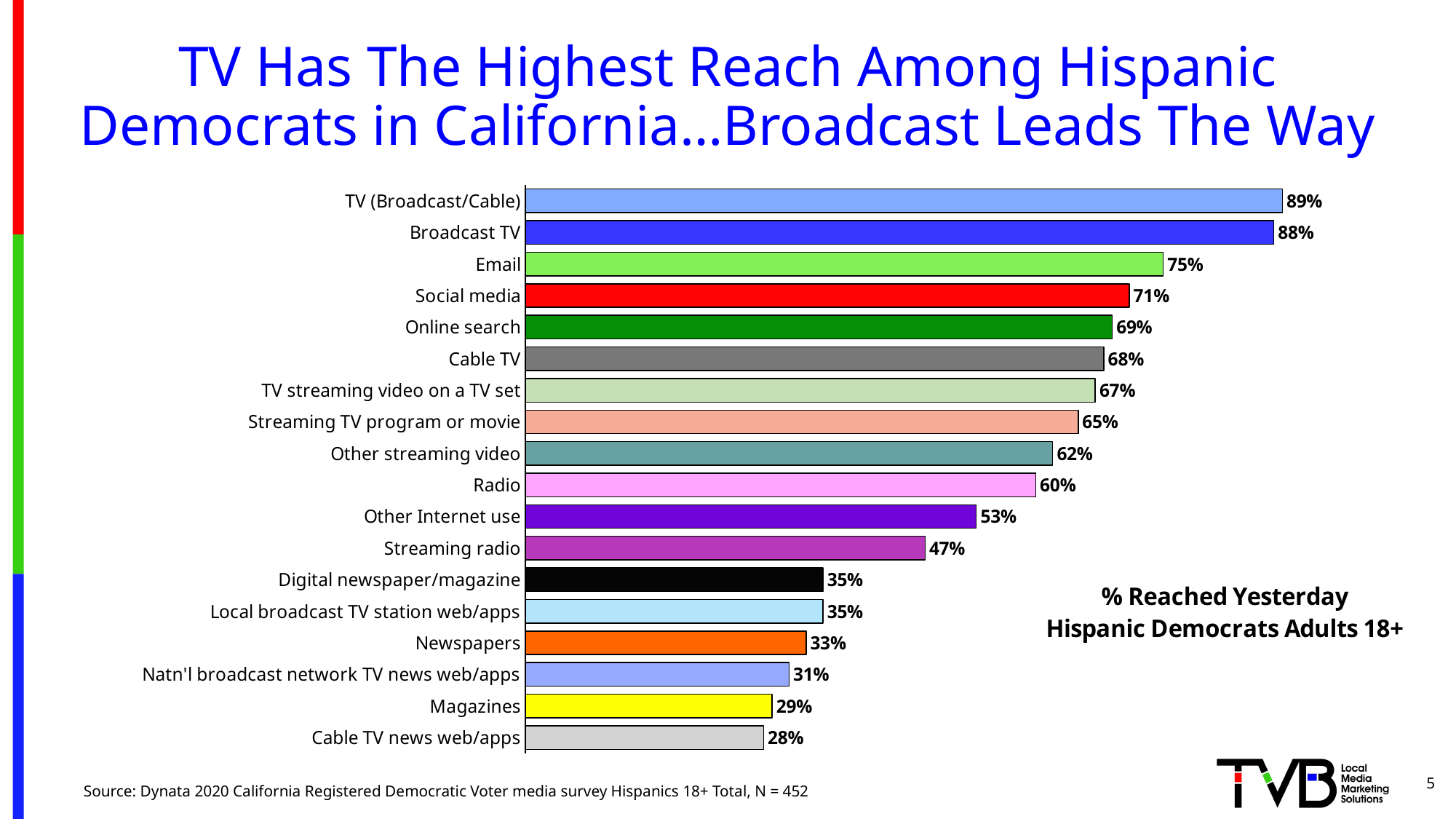
What is the difference between the values for Email and Social media? 4% What kind of chart is shown on the slide? Bar chart Which is larger, the value for Online search or the value for Cable TV? Online search What is the source cited at the bottom of the slide? Dynata 2020 California Registered Democratic Voter media survey Hispanics 18+ Total, N = 452 What is the value for Streaming radio? 47% How many categories are shown in the chart? 18 What is the value for Broadcast TV? 88% Which is larger, the value for Newspapers or the value for Magazines? Newspapers Which category has the highest value? TV (Broadcast/Cable) What is the difference between the values for TV (Broadcast/Cable) and Cable TV news web/apps? 61% Which category has the lowest value? Cable TV news web/apps What is the value for Radio? 60%